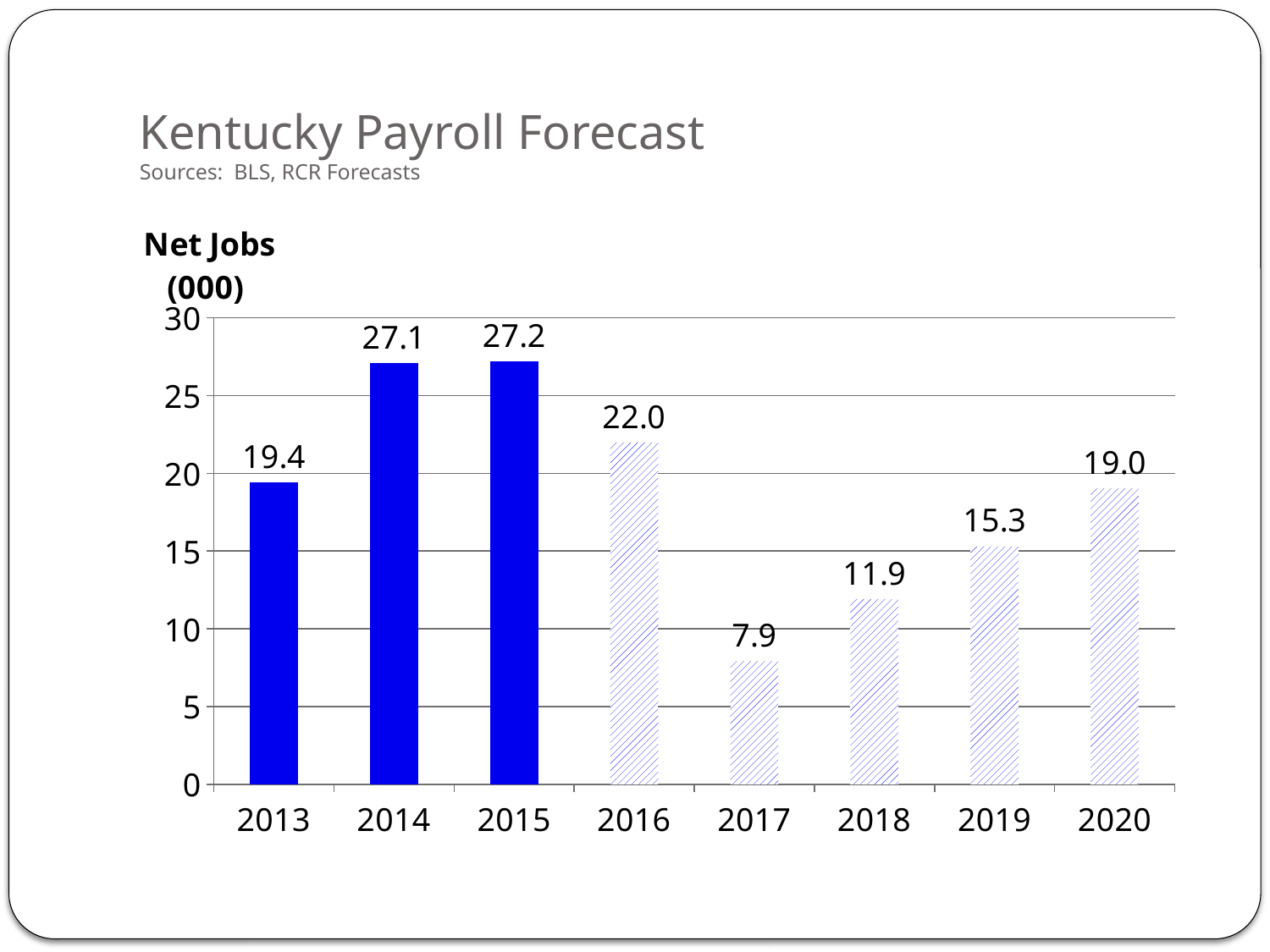
Which year has the highest net jobs value? 2015 Do the values rise or fall from 2017 to 2020? rise What is the net jobs value for 2017? 7.9 What kind of chart is shown on the slide? bar chart What is the difference between the net jobs values for 2016 and 2017? 14.1 How many years are shown on the x axis? 8 What is the net jobs value for 2013? 19.4 What is the net jobs value for 2020? 19.0 Which year has the lowest net jobs value? 2017 What is the title of the slide? Kentucky Payroll Forecast Is the value for 2016 greater or less than 20? greater Which year has a larger net jobs value, 2018 or 2019? 2019